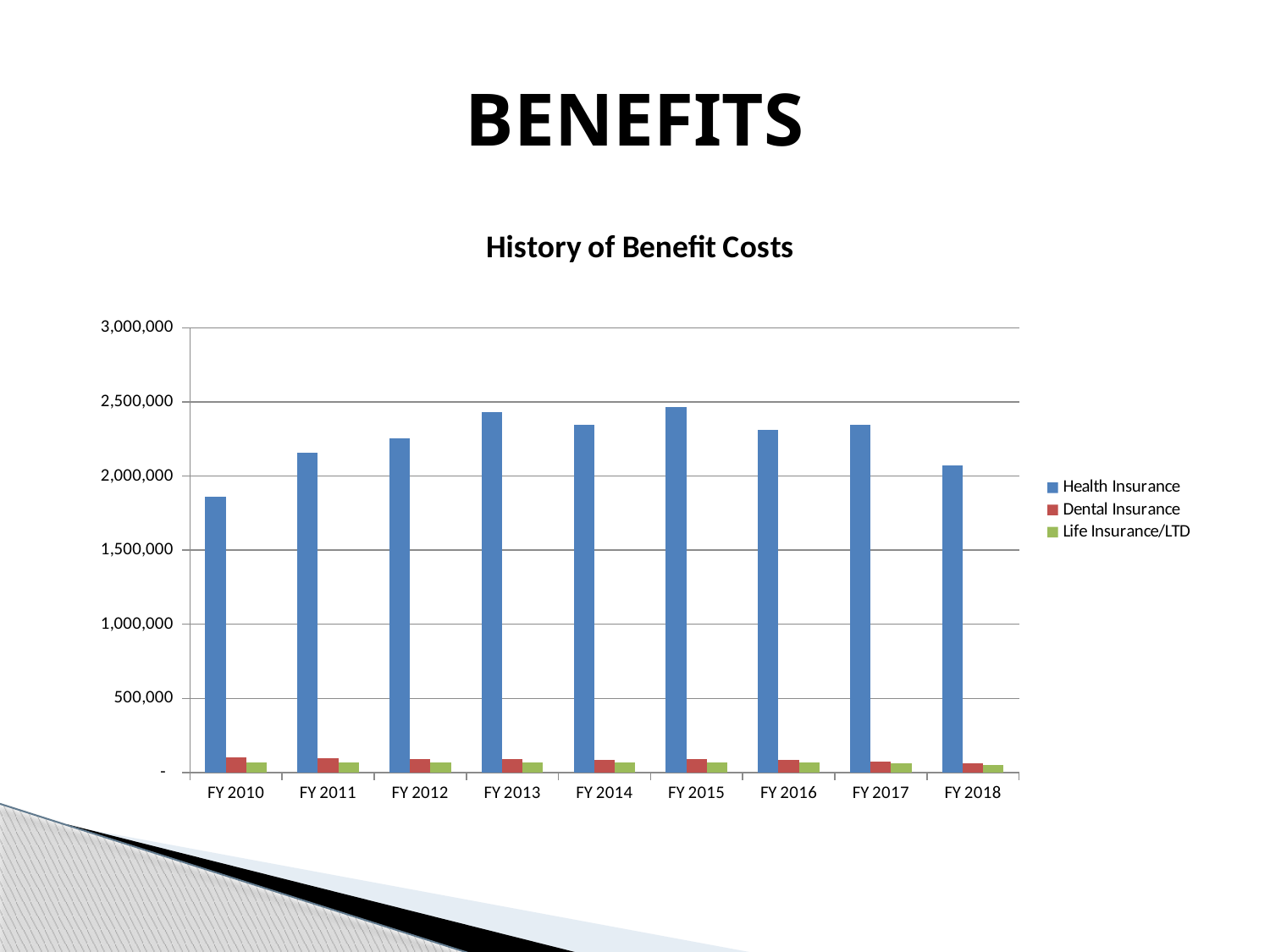
What kind of chart is shown on the slide? bar chart How many fiscal years are shown on the x axis? 9 Is the Health Insurance value for FY 2010 greater or less than 2,000,000? less What is the title of the chart? History of Benefit Costs Which series has the larger value in FY 2016, Health Insurance or Dental Insurance? Health Insurance Do Health Insurance costs rise or fall from FY 2015 to FY 2018? fall How many series does the legend list? 3 Which is larger, the Health Insurance cost in FY 2013 or in FY 2018? FY 2013 Is the Dental Insurance value for FY 2015 greater or less than 500,000? less Is the Health Insurance value for FY 2011 greater or less than 2,000,000? greater Which fiscal year has the lowest Health Insurance cost? FY 2010